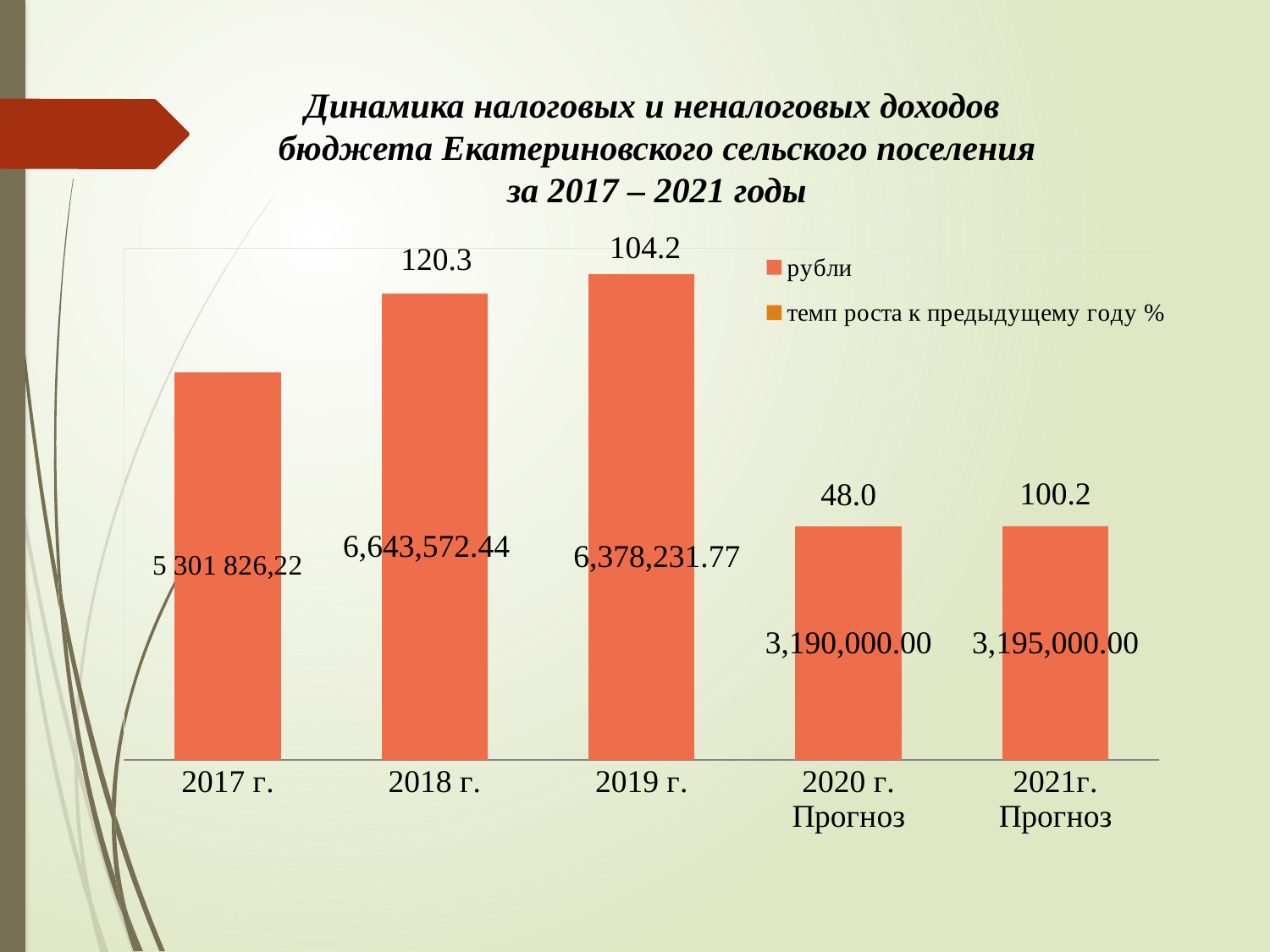
What is the growth rate to the previous year (темп роста к предыдущему году %) for 2018 г.? 120.3 What is the value in rubles for 2018 г.? 6,643,572.44 What kind of chart is shown on the slide? bar chart Which year has the lowest value in rubles? 2020 г. Прогноз How many series does the legend list? 2 Which is larger, the value in rubles for 2017 г. or for 2019 г.? 2019 г. What is the growth rate to the previous year (темп роста к предыдущему году %) for 2020 г. Прогноз? 48.0 What is the value in rubles for 2020 г. Прогноз? 3,190,000.00 What is the value in rubles for 2019 г.? 6,378,231.77 How many year categories are shown on the x axis? 5 What is the difference in rubles between 2021г. Прогноз and 2020 г. Прогноз? 5,000.00